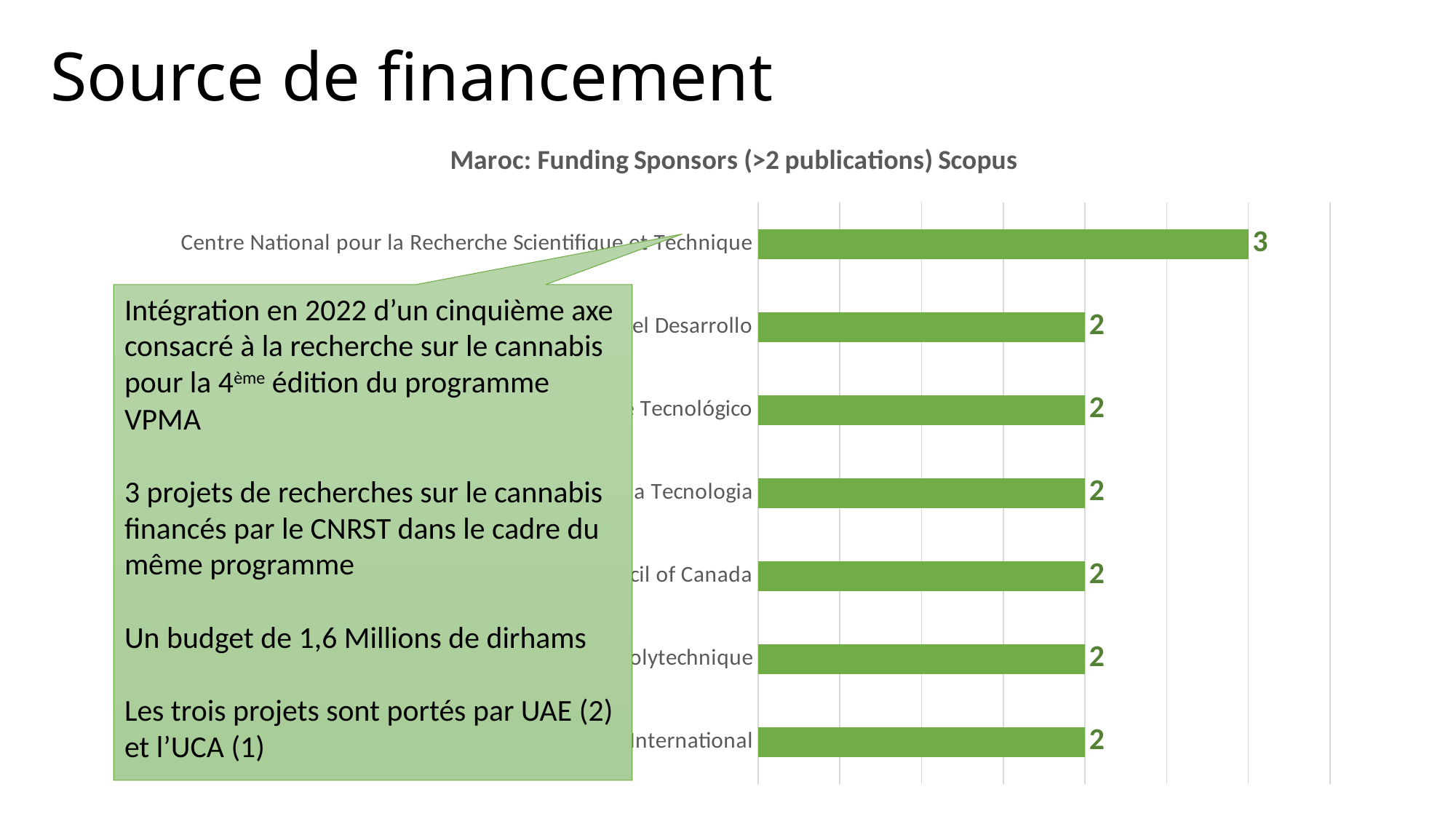
How many bars in the chart have a value of 2? 6 What type of chart is shown on the slide? bar chart What is the value for Centre National pour la Recherche Scientifique et Technique? 3 What is the title of the chart? Maroc: Funding Sponsors (>2 publications) Scopus Which funding sponsor has the highest value in the chart? Centre National pour la Recherche Scientifique et Technique How many bars (funding sponsors) are plotted in the chart? 7 What is the lowest value shown in the chart? 2 What is the highest value shown in the chart? 3 What colour are the bars in the chart? green What is the difference between the highest and the lowest value in the chart? 1